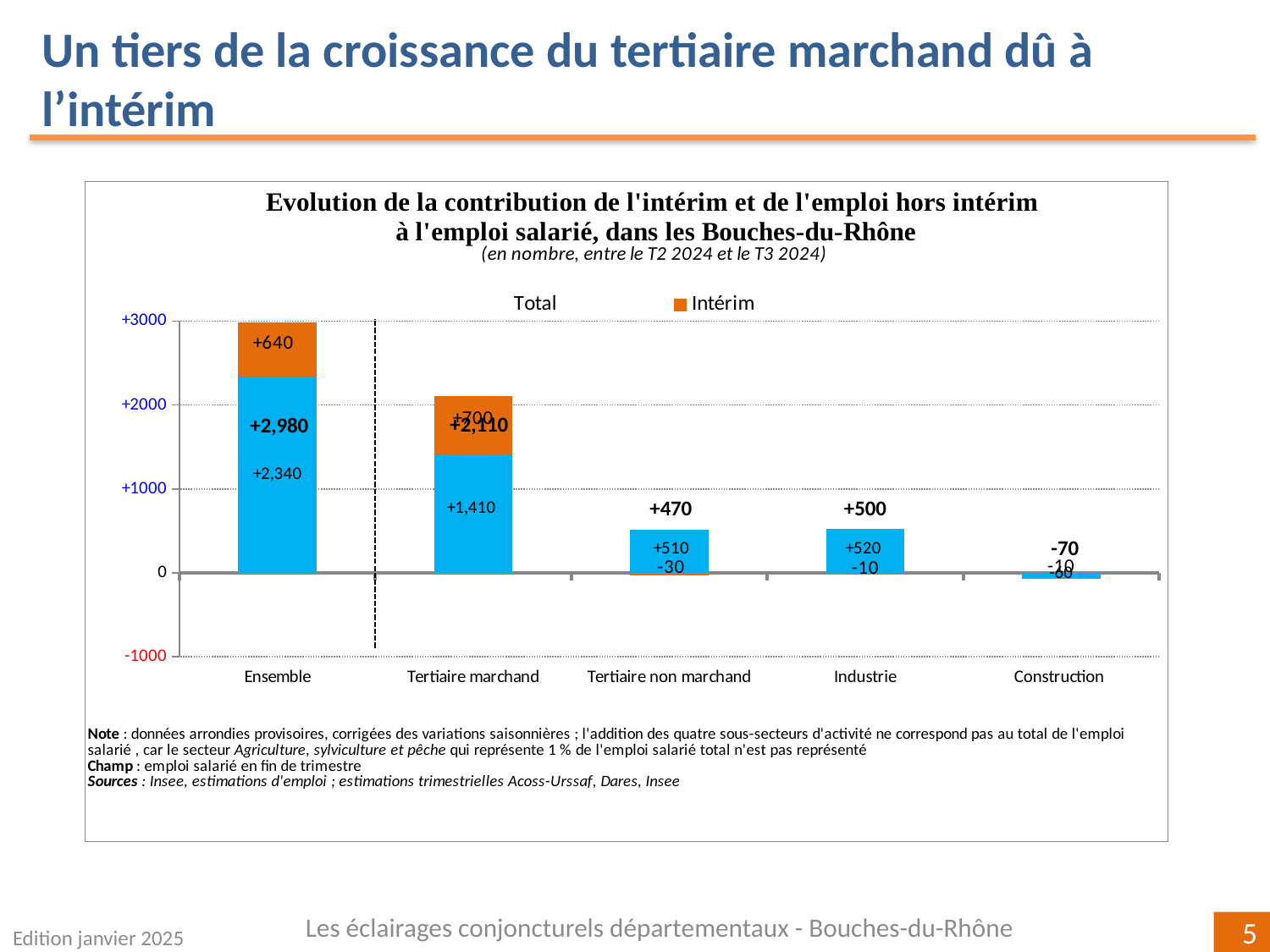
What is the difference between the total for Ensemble and the total for Tertiaire marchand? 870 What is the total value shown for Construction? -70 What is the total value shown for Industrie? +500 What kind of chart is this? Bar chart What is the total value shown for Ensemble? +2,980 Which category has the lowest total value? Construction What is the value of the blue (hors intérim) segment for Tertiaire marchand? +1,410 Which category has the highest total value? Ensemble Which has the larger total, Industrie or Tertiaire non marchand? Industrie What is the total value shown for Tertiaire marchand? +2,110 What is the Intérim value for Ensemble? +640 How many categories are shown on the x axis? 5